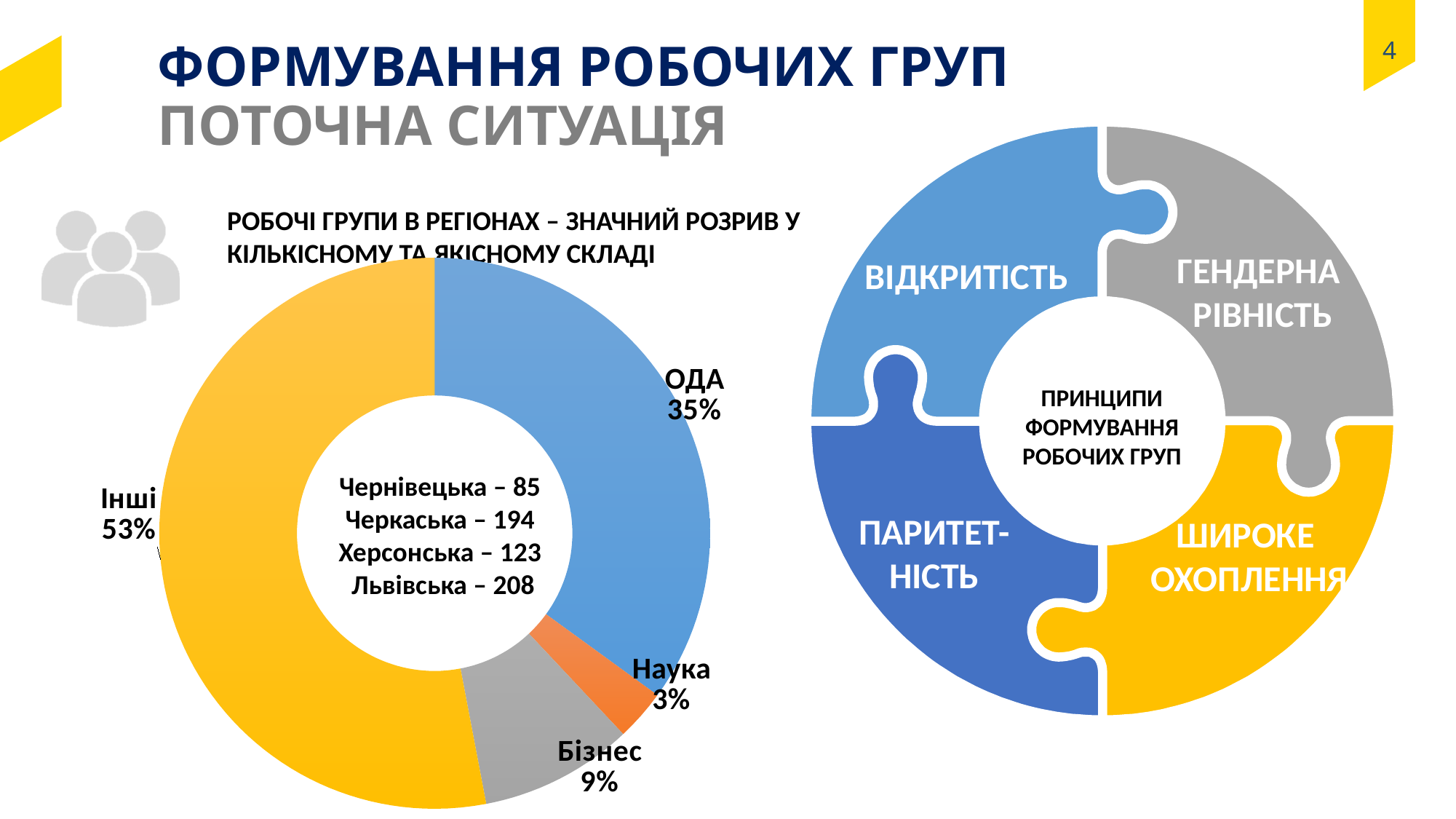
What share of the donut chart does the ОДА slice represent? 35% What colour is the ОДА slice in the donut chart? Blue Which slice of the donut chart is the smallest? Наука What is the combined share of the Бізнес and Наука slices in the donut chart? 12% What share of the donut chart does the Наука slice represent? 3% What is the difference in percentage points between the Інші and ОДА slices of the donut chart? 18 What share of the donut chart does the Бізнес slice represent? 9% What type of chart is shown on the left of the slide? Donut (pie) chart Which slice of the donut chart is the largest? Інші What share of the donut chart does the Інші slice represent? 53% Which slice of the donut chart is larger, Бізнес or Наука? Бізнес How many slices does the donut chart have? 4